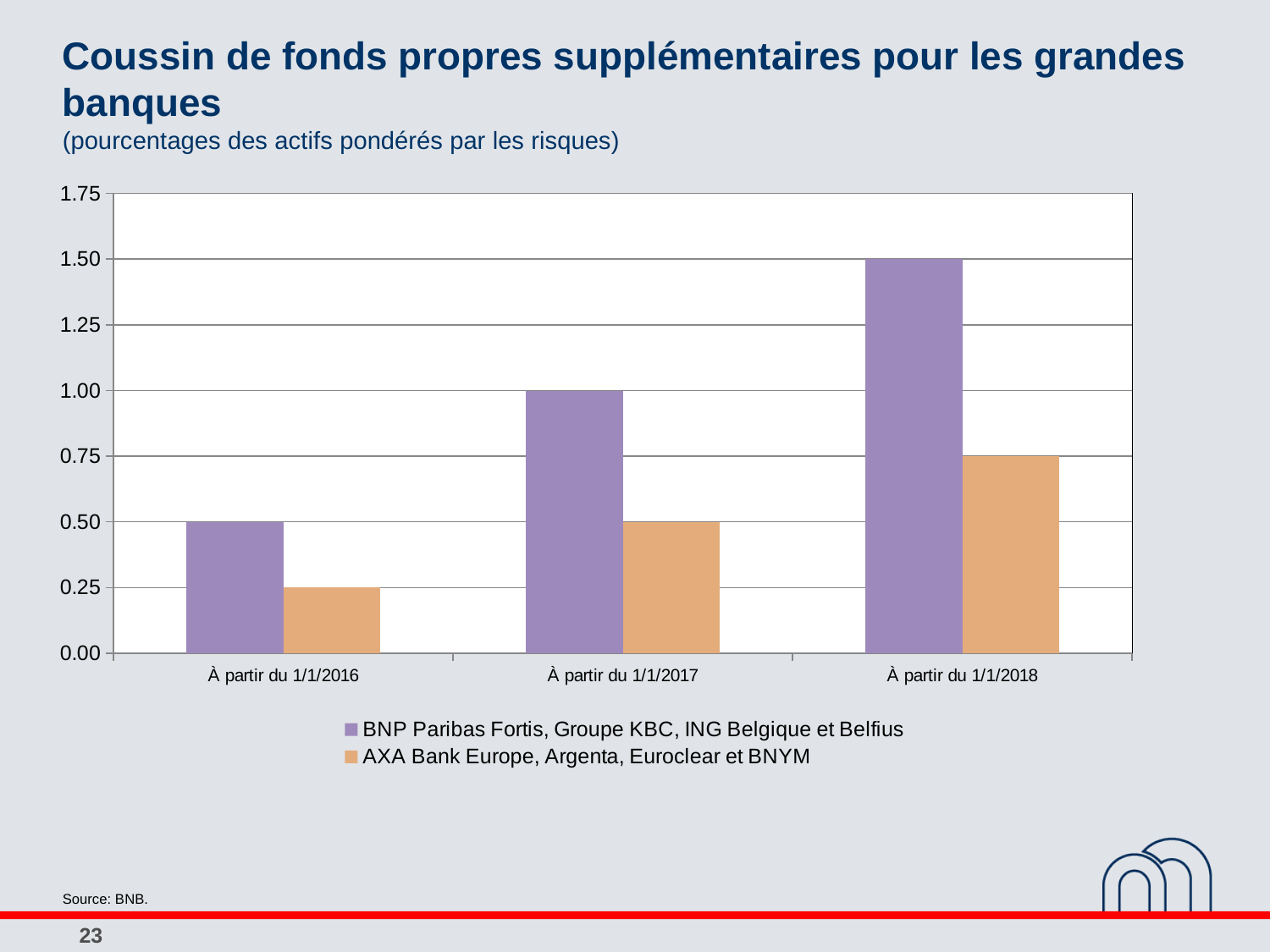
What kind of chart is shown on the slide? bar chart Which series has the larger value at 'À partir du 1/1/2017'? BNP Paribas Fortis, Groupe KBC, ING Belgique et Belfius What is the value for AXA Bank Europe, Argenta, Euroclear et BNYM at 'À partir du 1/1/2018'? 0.75 What is the value for BNP Paribas Fortis, Groupe KBC, ING Belgique et Belfius at 'À partir du 1/1/2017'? 1.00 What is the difference between the two series at 'À partir du 1/1/2018'? 0.75 Do the values for AXA Bank Europe, Argenta, Euroclear et BNYM rise or fall from 2016 to 2018? rise How many categories are shown on the x axis? 3 What is the value for BNP Paribas Fortis, Groupe KBC, ING Belgique et Belfius at 'À partir du 1/1/2018'? 1.50 In which category is the value for BNP Paribas Fortis, Groupe KBC, ING Belgique et Belfius highest? À partir du 1/1/2018 In which category is the value for AXA Bank Europe, Argenta, Euroclear et BNYM lowest? À partir du 1/1/2016 What is the value for AXA Bank Europe, Argenta, Euroclear et BNYM at 'À partir du 1/1/2016'? 0.25 How many series does the legend list? 2